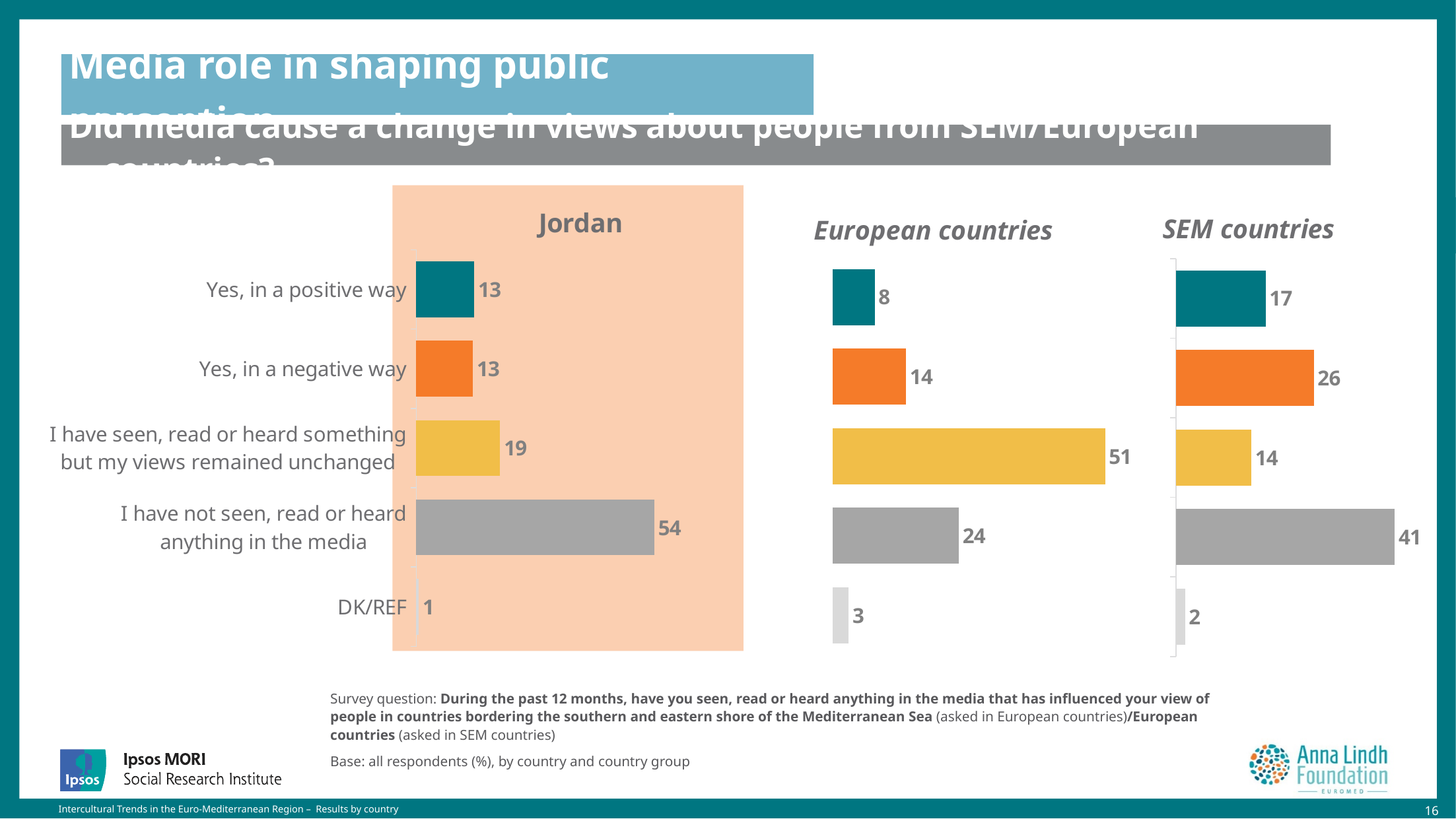
In the SEM countries chart, what is the value for 'Yes, in a negative way'? 26 In the Jordan chart, what is the value for DK/REF? 1 In the European countries chart, what is the difference between 'Yes, in a negative way' and 'Yes, in a positive way'? 6 In the Jordan chart, what colour is the bar for 'Yes, in a negative way'? Orange In the Jordan chart, which category has the highest value? I have not seen, read or heard anything in the media Is the value for 'Yes, in a positive way' larger in the Jordan chart or in the European countries chart? Jordan In the Jordan chart, what is the value for 'I have not seen, read or heard anything in the media'? 54 In the SEM countries chart, what is the difference between 'I have not seen, read or heard anything in the media' and 'Yes, in a positive way'? 24 How many categories are shown in the Jordan chart? 5 In the European countries chart, what is the value for 'I have seen, read or heard something but my views remained unchanged'? 51 What type of chart is the Jordan chart? Bar chart In the European countries chart, which category has the lowest value? DK/REF